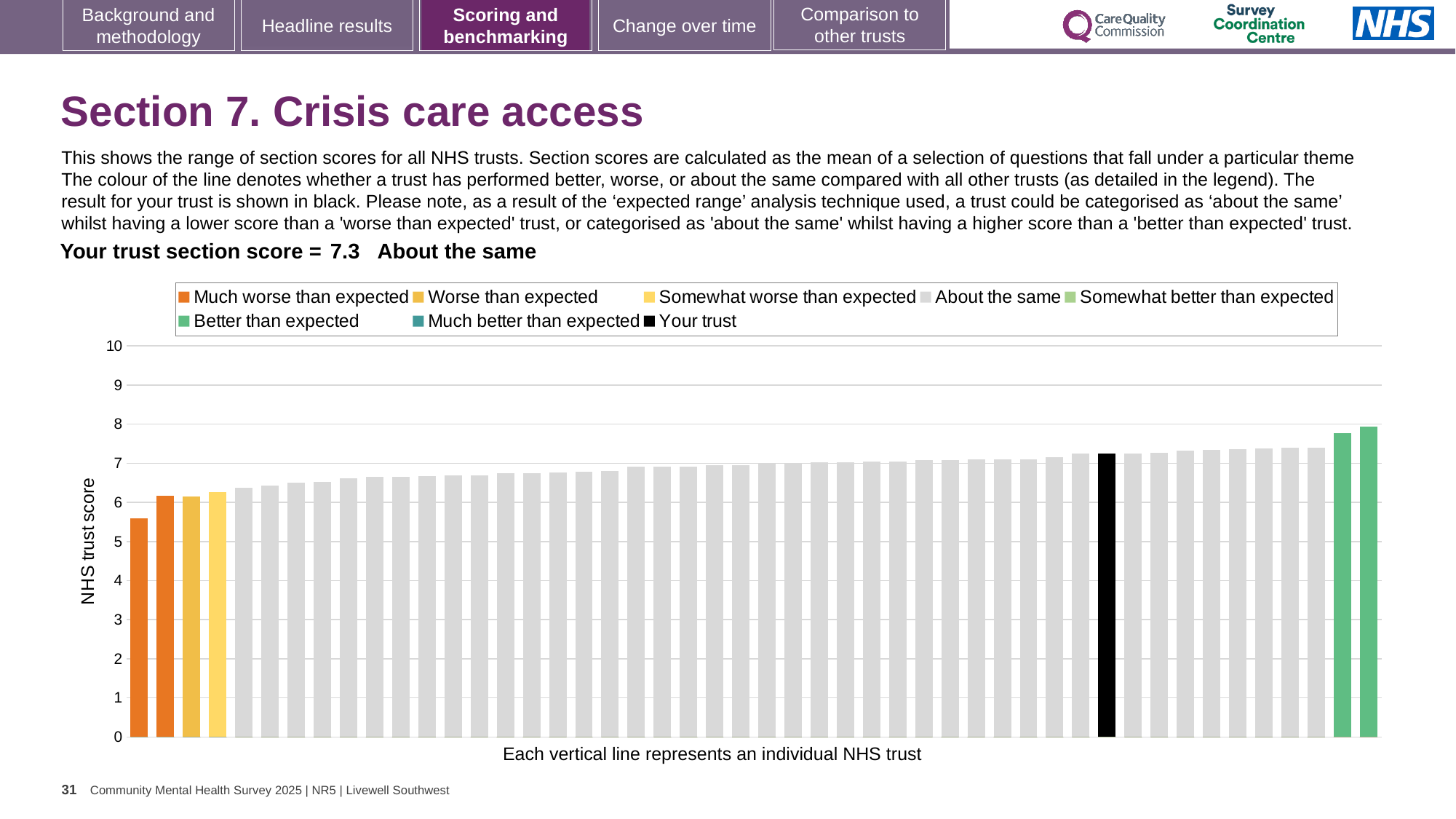
Is the value of the black bar (your trust) greater or less than 7? greater How many bars are coloured 'Much worse than expected' (dark orange)? 2 Do the bar values rise or fall from left to right along the x axis? rise Is the value of the highest bar greater or less than 7? greater How many entries does the chart legend list? 8 What is the label on the vertical axis of the chart? NHS trust score Which legend category does the lowest bar belong to? Much worse than expected Which category is your trust's section score placed in? About the same What is the section score for your trust? 7.3 Which legend category does the highest bar belong to? Better than expected What kind of chart is shown on the slide? bar chart Is the value of the lowest bar greater or less than 6? less